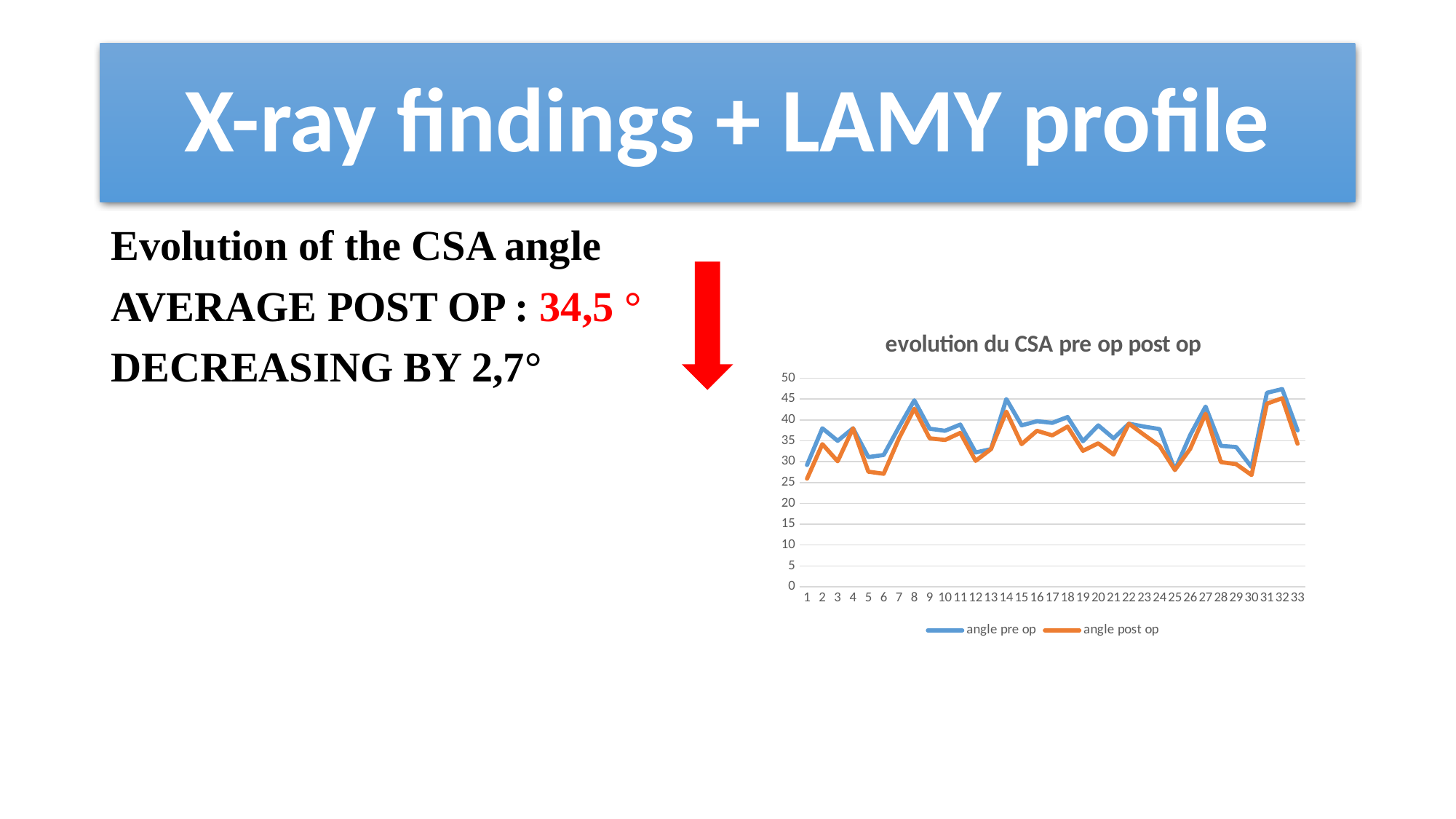
What colour is the 'angle post op' line in the chart? orange At which point does the 'angle post op' series reach its highest value? 32 At point 6, which series has the larger value, 'angle pre op' or 'angle post op'? angle pre op At which point does the 'angle pre op' series reach its highest value? 32 Is the 'angle pre op' value at point 32 greater or less than 45? greater How many series does the legend of the chart list? 2 Is the 'angle post op' value at point 30 greater or less than 30? less Is the 'angle post op' value at point 1 greater or less than 30? less How many points are plotted along the x axis of the chart? 33 What kind of chart is shown on the slide? line chart What is the title of the chart? evolution du CSA pre op post op